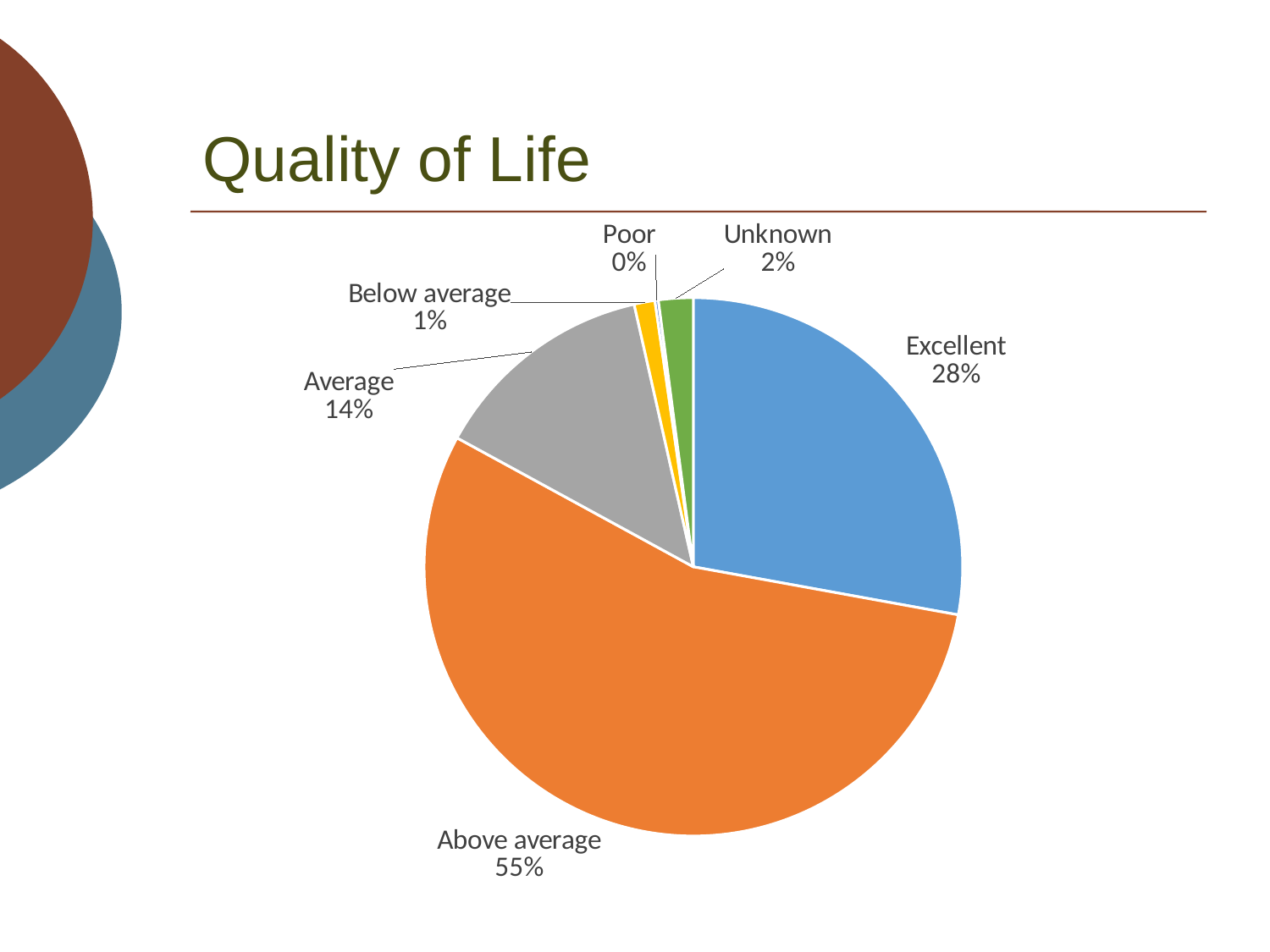
Which is larger, the Average slice or the Excellent slice? Excellent What share of the pie is labelled Unknown? 2% How many categories are shown in the pie chart? 6 What kind of chart is shown on the slide? Pie chart What share of the pie is labelled Excellent? 28% What share of the pie is labelled Above average? 55% Which category has the largest slice of the pie? Above average What is the difference in percentage points between Above average and Excellent? 27 Which category has the smallest slice of the pie? Poor